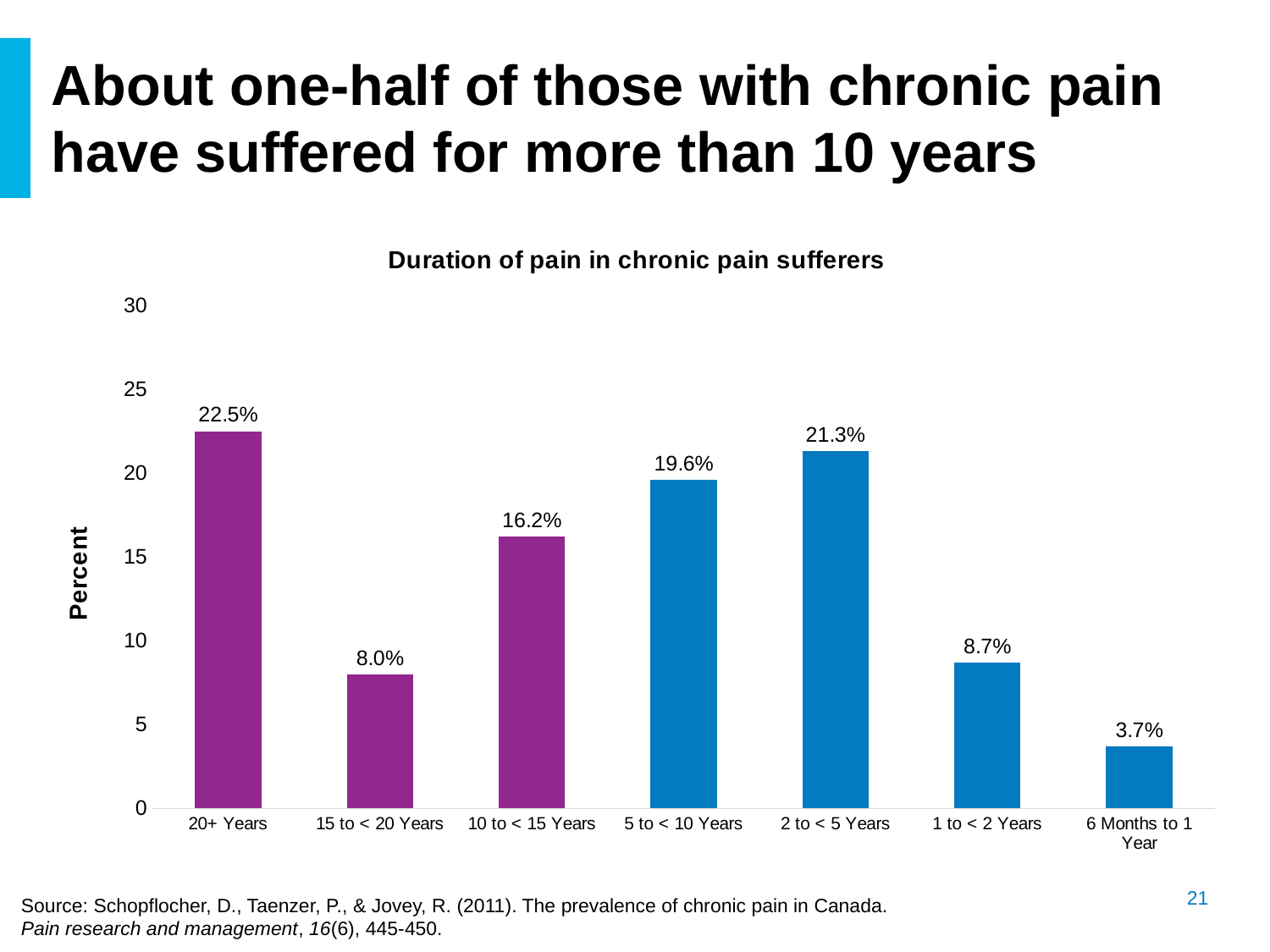
Which category has the lowest value? 6 Months to 1 Year What is the label on the y axis? Percent What is the title of the chart? Duration of pain in chronic pain sufferers Which category has the highest value? 20+ Years Which is larger, the value for 10 to < 15 Years or the value for 15 to < 20 Years? 10 to < 15 Years What is the difference between the values for 2 to < 5 Years and 1 to < 2 Years? 12.6% What kind of chart is shown on the slide? bar chart Is the value for 2 to < 5 Years greater or less than 20? greater What is the value for the 5 to < 10 Years category? 19.6% What is the value for the 6 Months to 1 Year category? 3.7% How many categories are shown on the x axis? 7 What is the value for the 20+ Years category? 22.5%